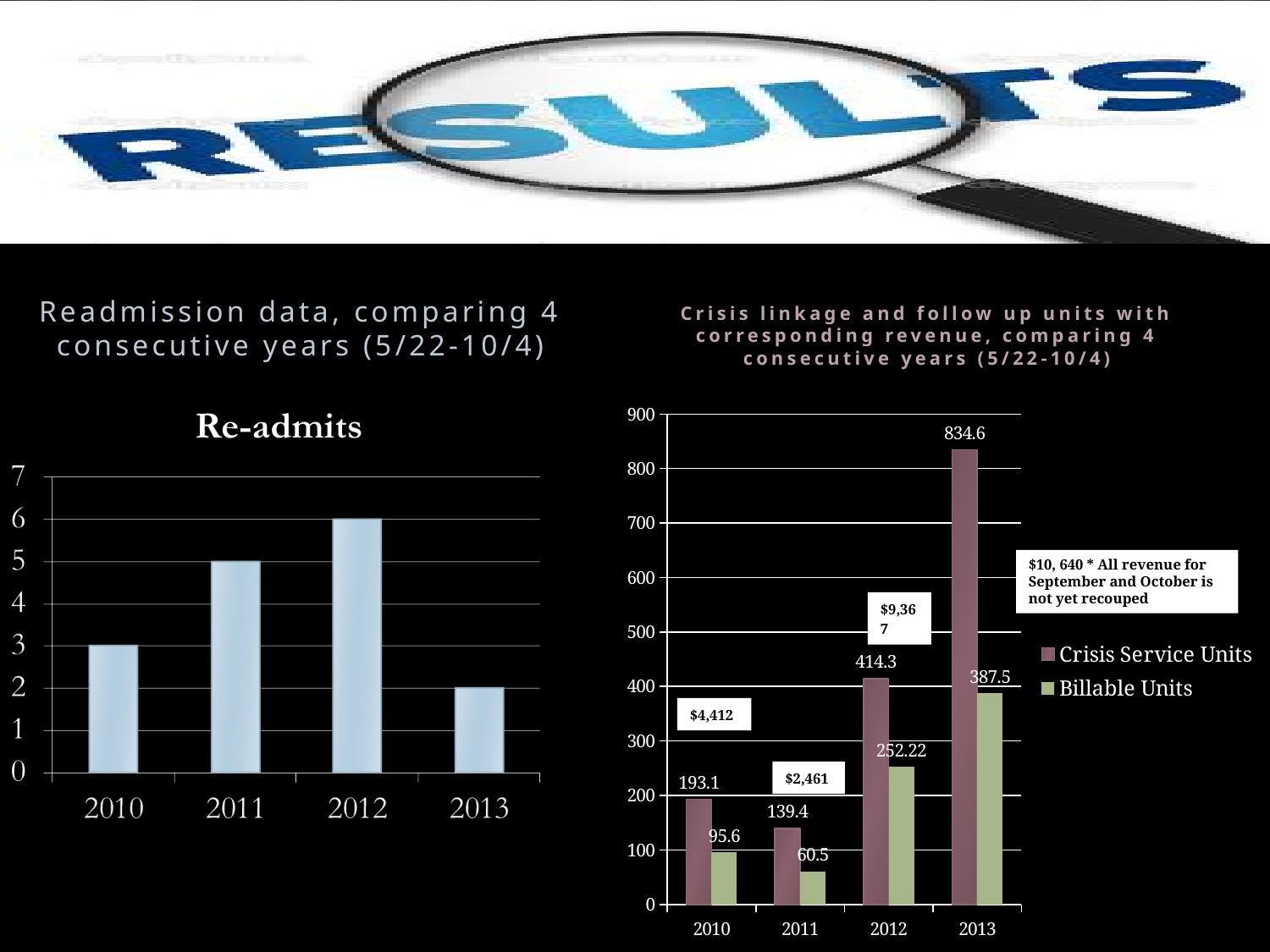
In the Crisis linkage and follow up units chart, which year has the lowest Billable Units value? 2011 In the Re-admits chart, which year has the lowest number of re-admits? 2013 In the Re-admits chart, what is the difference between the values for 2011 and 2013? 3 In the Crisis linkage and follow up units chart, which is larger in 2010: Crisis Service Units or Billable Units? Crisis Service Units What kind of chart is the Re-admits chart? bar chart In the Crisis linkage and follow up units chart, what is the value of Billable Units for 2012? 252.22 In the Crisis linkage and follow up units chart, what is the value of Crisis Service Units for 2013? 834.6 In the Crisis linkage and follow up units chart, do the Crisis Service Units values rise or fall from 2011 to 2013? rise In the Re-admits chart, which year has the highest number of re-admits? 2012 How many series does the legend of the Crisis linkage and follow up units chart list? 2 In the Crisis linkage and follow up units chart, what is the difference between Crisis Service Units and Billable Units in 2013? 447.1 In the Re-admits chart, what is the value for 2012? 6